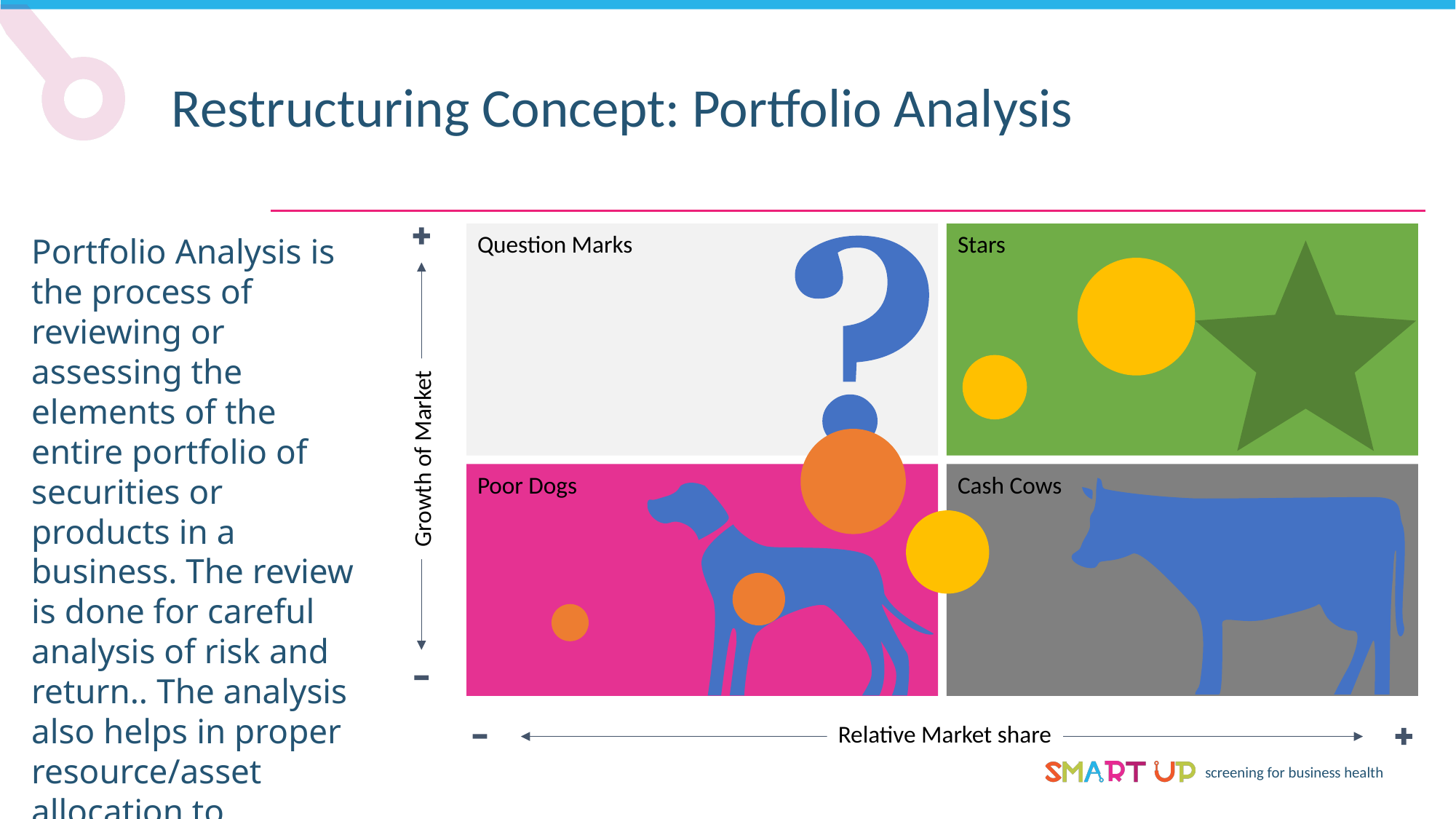
What does the vertical axis of the matrix represent? Growth of Market Which quadrant is in the bottom-right position (low growth, high market share)? Cash Cows How many quadrants does the matrix have? 4 Which quadrant is in the top-right position (high growth, high market share)? Stars Which quadrant is in the top-left position (high growth, low market share)? Question Marks What does the horizontal axis of the matrix represent? Relative Market share Which quadrant is in the bottom-left position (low growth, low market share)? Poor Dogs What kind of chart is shown on the slide? A bubble chart drawn over a 2x2 quadrant matrix